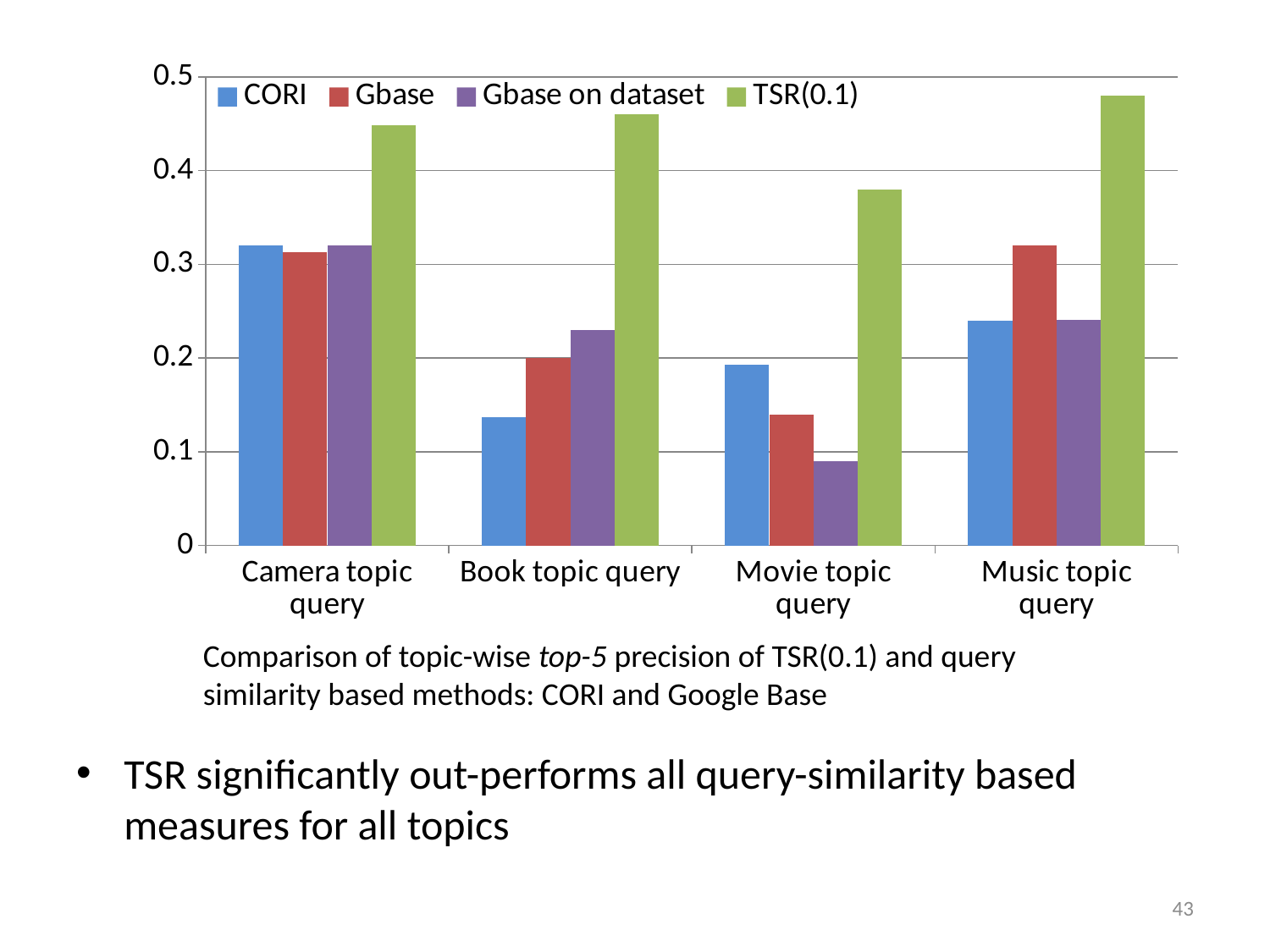
Is the CORI value for Book topic query greater or less than 0.2? less Is the Gbase on dataset value for Movie topic query greater or less than 0.1? less Which series has the lowest value for Movie topic query? Gbase on dataset Is the TSR(0.1) value for Movie topic query greater or less than 0.4? less How many series does the legend list? 4 What colour are the TSR(0.1) bars in the chart? green What kind of chart is shown on the slide? bar chart Which series has the highest value for Movie topic query? TSR(0.1) For Music topic query, which is larger: the Gbase value or the CORI value? Gbase How many topic query categories are shown on the x axis? 4 For Book topic query, which is larger: the CORI value or the Gbase on dataset value? Gbase on dataset